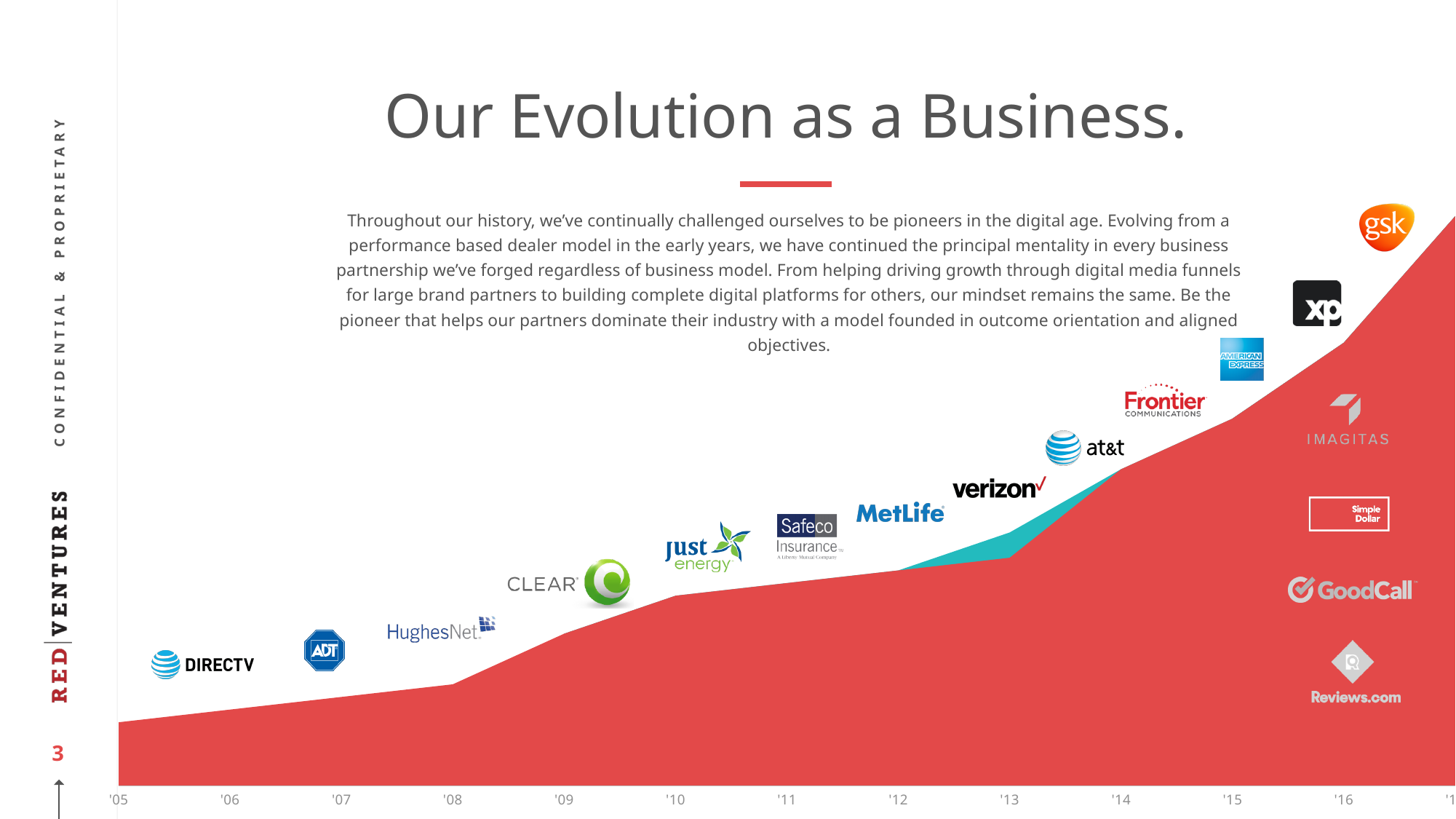
What is the first year label shown on the x axis of the chart? '05 Which year has the larger value in the chart, '05 or '16? '16 What kind of chart is shown on the slide? area chart Which year has the larger value in the chart, '10 or '14? '14 What is the title of the slide containing the chart? Our Evolution as a Business. Which year has the larger value in the chart, '13 or '09? '13 Do the values in the chart rise or fall from '05 to '16 along the x axis? rise